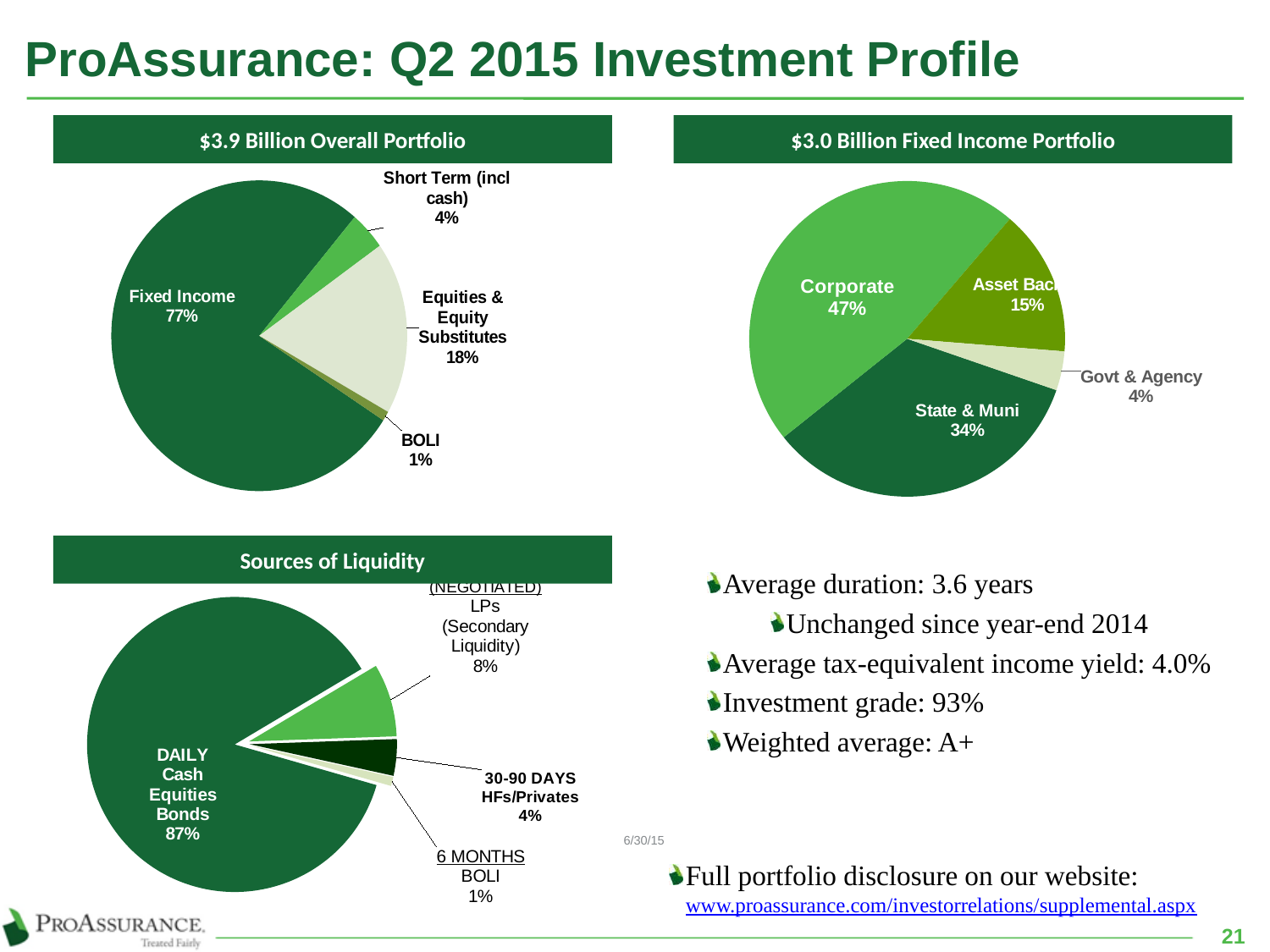
In the Sources of Liquidity chart, what share is DAILY Cash Equities Bonds? 87% What type of chart is the Sources of Liquidity chart? Pie chart In the $3.0 Billion Fixed Income Portfolio chart, what is the difference between the Corporate and State & Muni shares? 13% In the $3.9 Billion Overall Portfolio chart, how many categories are shown? 4 In the $3.0 Billion Fixed Income Portfolio chart, which category has the largest share? Corporate In the $3.9 Billion Overall Portfolio chart, what share is Fixed Income? 77% In the Sources of Liquidity chart, what share is 30-90 DAYS HFs/Privates? 4% In the $3.9 Billion Overall Portfolio chart, which category has the smallest share? BOLI In the $3.0 Billion Fixed Income Portfolio chart, which is larger, Govt & Agency or State & Muni? State & Muni In the $3.0 Billion Fixed Income Portfolio chart, what share is Corporate? 47% In the $3.9 Billion Overall Portfolio chart, what share is Equities & Equity Substitutes? 18% In the $3.0 Billion Fixed Income Portfolio chart, what share is State & Muni? 34%